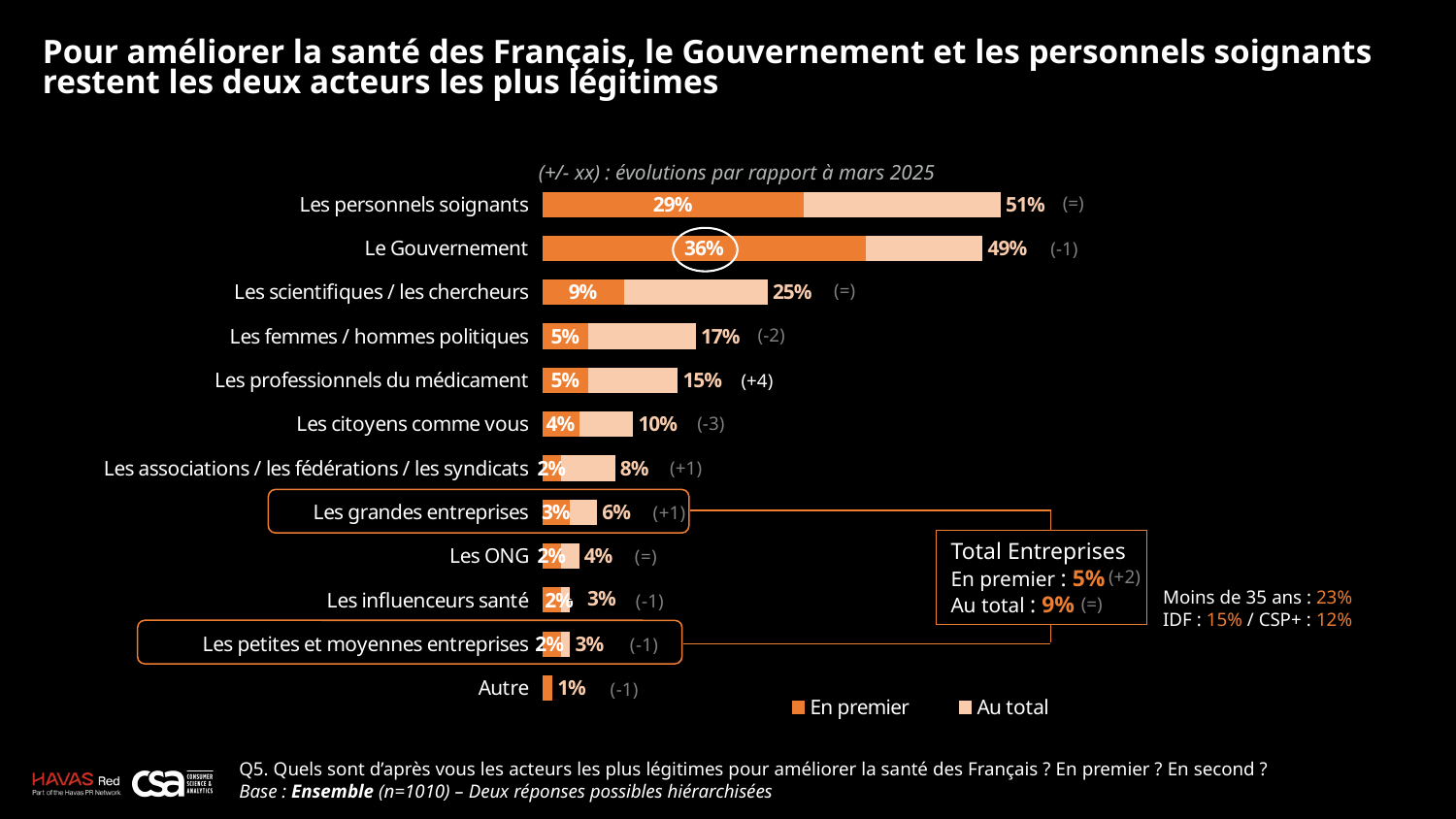
What is the 'Au total' value for Les personnels soignants? 51% What is the difference in 'Au total' value between Les personnels soignants and Le Gouvernement? 2 points How many series does the legend list? 2 How many categories are shown in the chart? 12 Which category has the highest 'Au total' value? Les personnels soignants Which has a larger 'Au total' value: Les femmes / hommes politiques or Les professionnels du médicament? Les femmes / hommes politiques What is the 'En premier' value for Les citoyens comme vous? 4% What kind of chart is shown on the slide? Bar chart What is the 'Au total' value for Les scientifiques / les chercheurs? 25% Which category has the lowest 'Au total' value? Autre Which category has the highest 'En premier' value? Le Gouvernement What is the 'En premier' value for Le Gouvernement? 36%